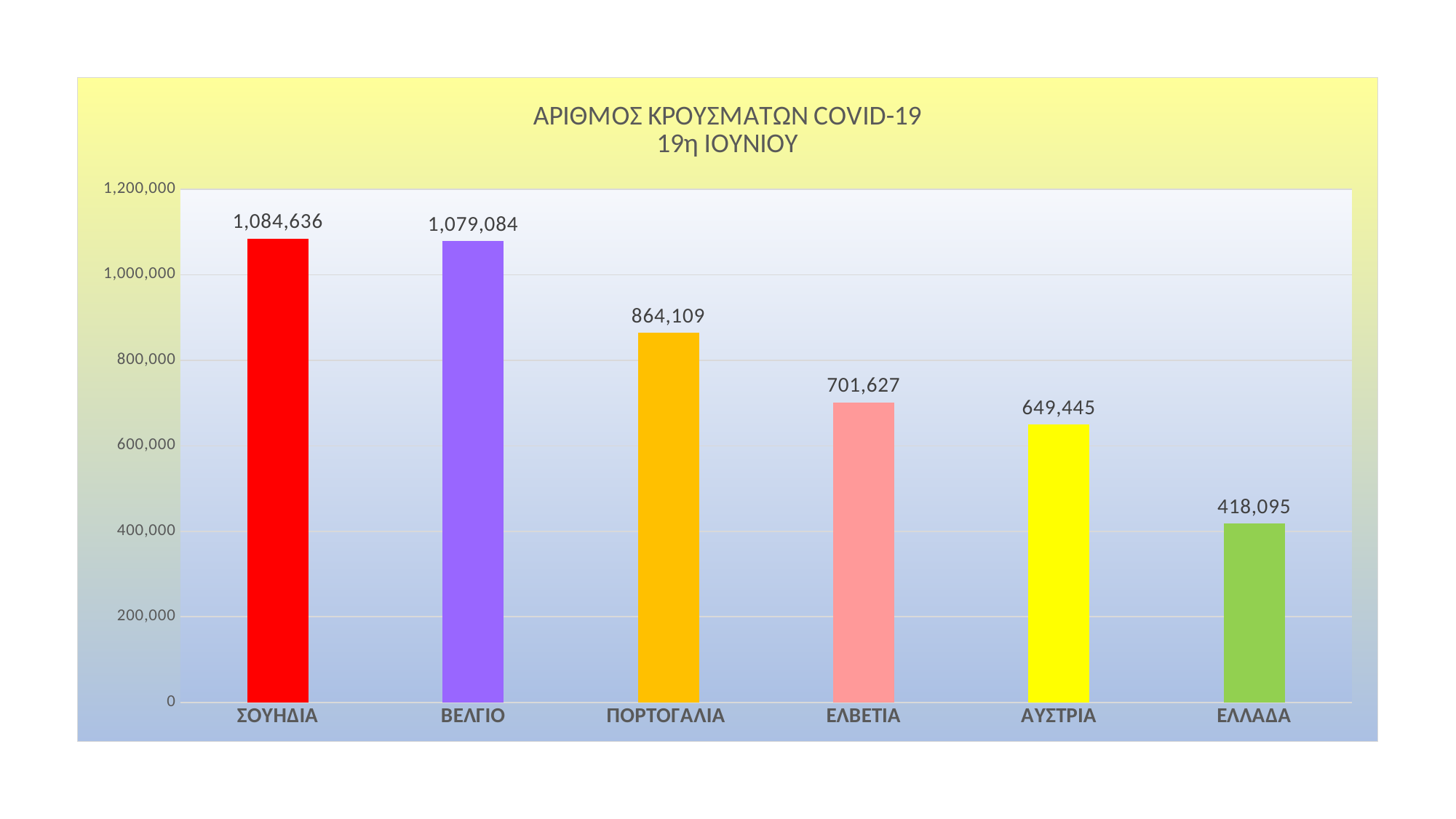
What is the value for ΕΛΛΑΔΑ? 418,095 What is the difference between the values for ΑΥΣΤΡΙΑ and ΕΛΛΑΔΑ? 231,350 How many countries are shown in the chart? 6 What type of chart is shown on the slide? Bar chart What is the difference between the values for ΠΟΡΤΟΓΑΛΙΑ and ΕΛΒΕΤΙΑ? 162,482 Do the values rise or fall from left to right across the chart? Fall Which country has the highest value? ΣΟΥΗΔΙΑ What is the title of the chart? ΑΡΙΘΜΟΣ ΚΡΟΥΣΜΑΤΩΝ COVID-19 19η ΙΟΥΝΙΟΥ What is the value for ΠΟΡΤΟΓΑΛΙΑ? 864,109 What is the value for ΒΕΛΓΙΟ? 1,079,084 Which is larger, the value for ΕΛΒΕΤΙΑ or the value for ΑΥΣΤΡΙΑ? ΕΛΒΕΤΙΑ Which country has the lowest value? ΕΛΛΑΔΑ